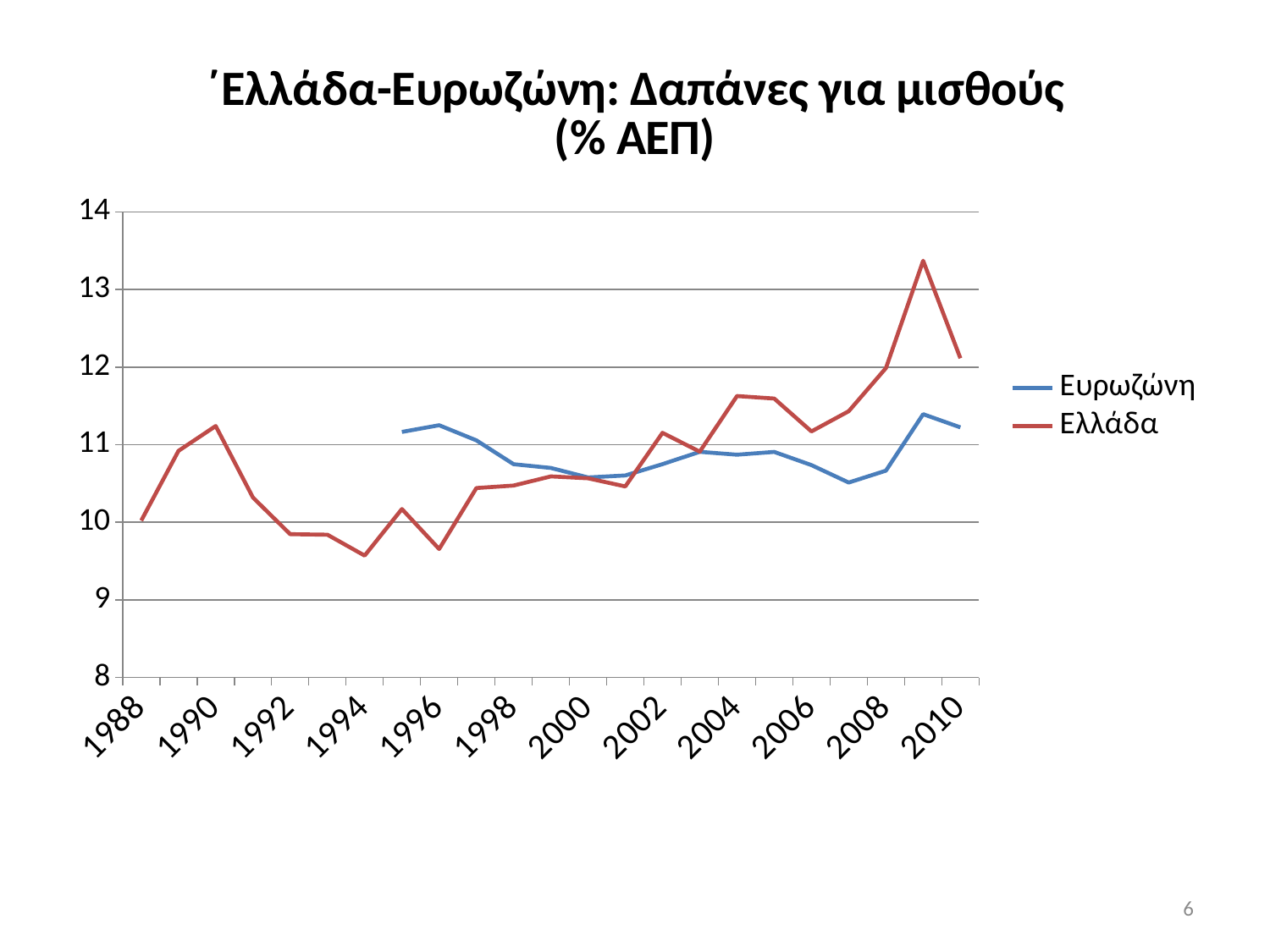
In 1996, which series has the higher value, Ευρωζώνη or Ελλάδα? Ευρωζώνη Is the value for Ευρωζώνη in 2007 greater or less than 11? less Does the Ελλάδα series rise or fall between 2006 and 2009? rise Is the value for Ελλάδα in 1994 greater or less than 10? less Is the value for Ελλάδα in 1988 greater or less than 11? less What are the two series named in the legend? Ευρωζώνη and Ελλάδα What kind of chart is shown on the slide? line chart In which year does the Ελλάδα series reach its highest value? 2009 How many series does the legend list? 2 In 2009, which series has the higher value, Ευρωζώνη or Ελλάδα? Ελλάδα Does the Ελλάδα series rise or fall between 2009 and 2010? fall